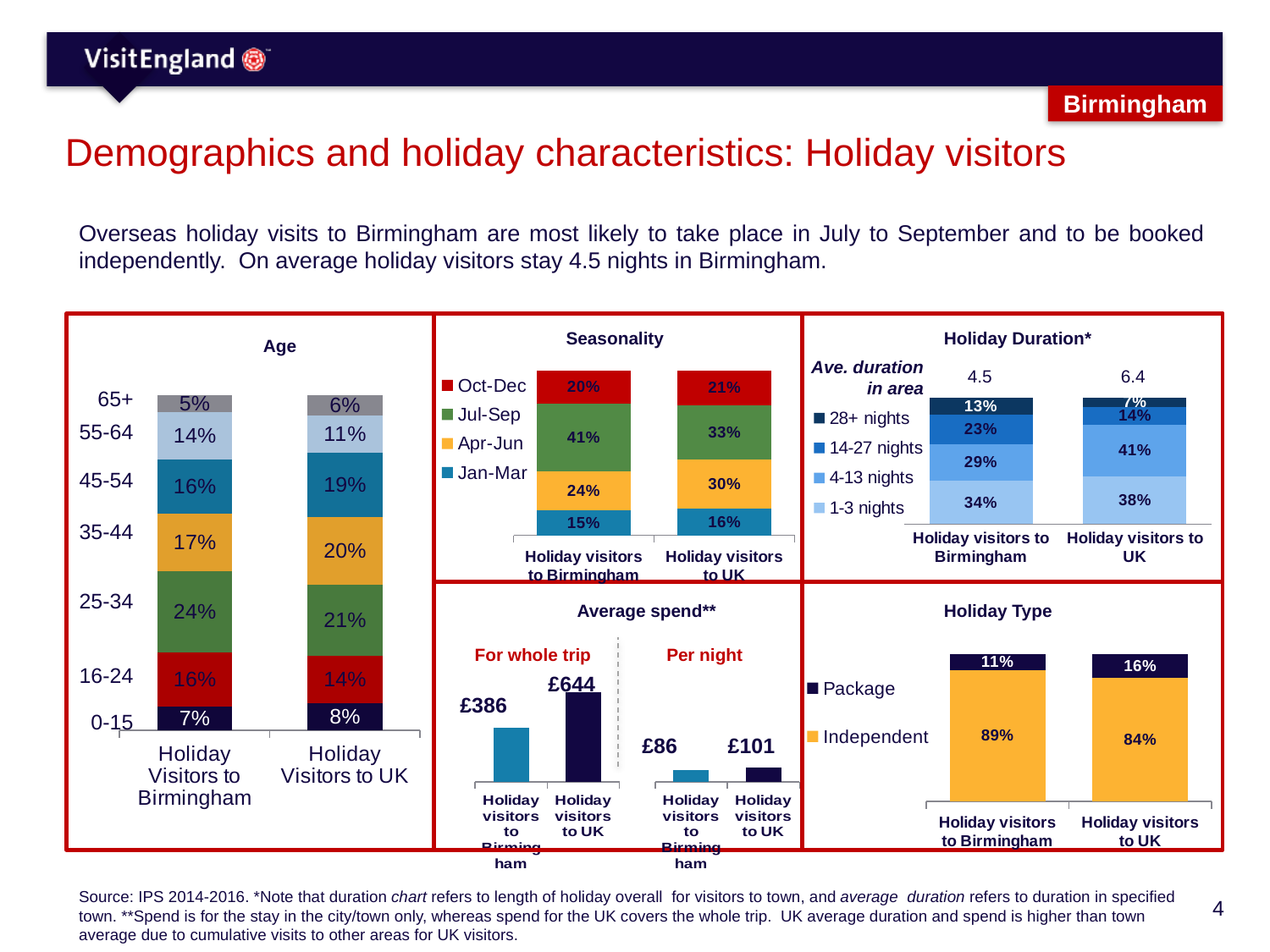
In the Age chart, what share of holiday visitors to Birmingham are aged 25-34? 24% In the Holiday Duration chart, what share of holiday visitors to UK stay 4-13 nights? 41% In the Holiday Type chart, which is larger: the Package share for holiday visitors to Birmingham or for holiday visitors to UK? Holiday visitors to UK In the Seasonality chart, what share of holiday visitors to Birmingham visit in Jul-Sep? 41% In the Average spend chart, what is the difference in per night spend between holiday visitors to UK and holiday visitors to Birmingham? £15 In the Holiday Duration chart, what is the average duration in area for holiday visitors to Birmingham? 4.5 In the Age chart, what is the difference between the 35-44 shares for holiday visitors to UK and holiday visitors to Birmingham? 3% What kind of chart is the Holiday Type chart? Stacked bar chart In the Average spend chart, what is the spend for the whole trip for holiday visitors to UK? £644 In the Seasonality chart, which season has the smallest share for holiday visitors to UK? Jan-Mar In the Age chart, which age group is the largest for holiday visitors to UK? 25-34 How many series does the legend of the Seasonality chart list? 4